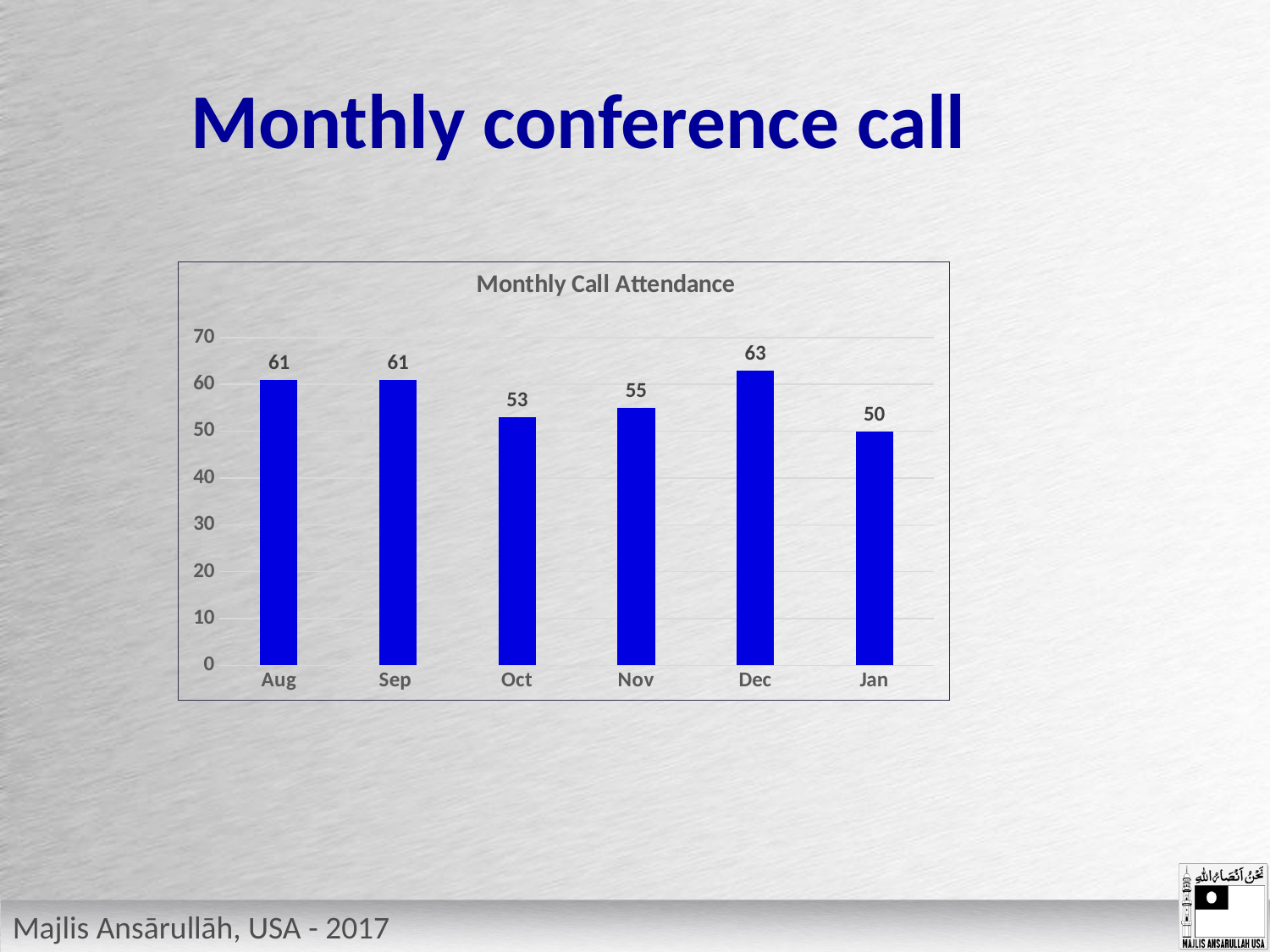
What is the monthly call attendance for Oct? 53 What is the difference in attendance between Aug and Oct? 8 What is the difference in attendance between Dec and Jan? 13 How many months are shown in the chart? 6 What is the title of the chart? Monthly Call Attendance Is the value for Oct greater or less than 60? less Which month has the lowest call attendance? Jan What is the monthly call attendance for Jan? 50 Which month has higher attendance, Nov or Dec? Dec What kind of chart is shown on the slide? bar chart Which month has the highest call attendance? Dec What is the monthly call attendance for Nov? 55